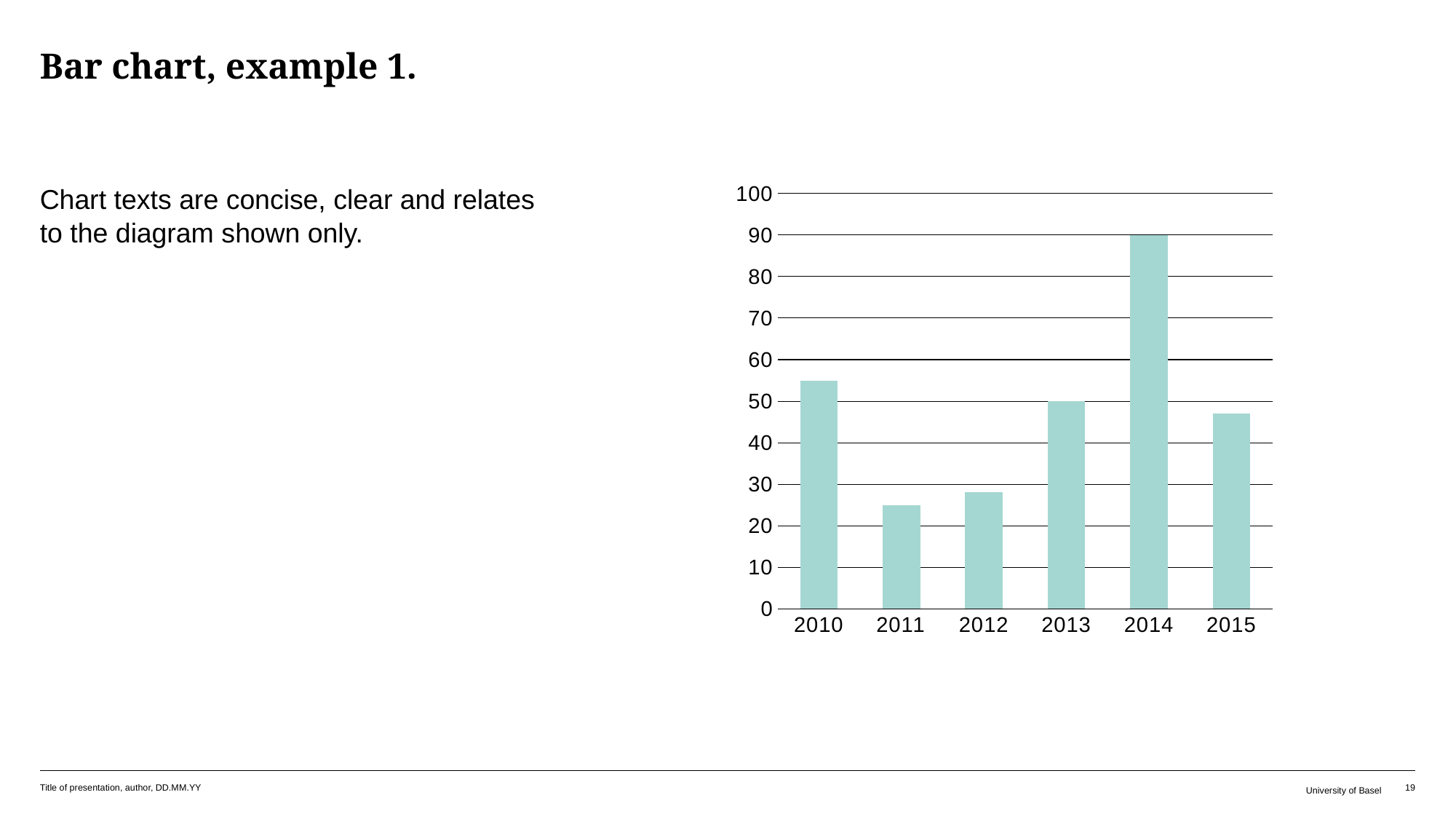
What is the value for 2013? 50 What kind of chart is shown on the slide? bar chart Do the values rise or fall from 2011 to 2014? rise Which year has the lowest value? 2011 What is the difference between the values for 2014 and 2013? 40 Which is larger, the value for 2010 or the value for 2015? 2010 Is the value for 2010 greater or less than 50? greater How many years are shown on the x axis of the chart? 6 Is the value for 2015 greater or less than 50? less Is the value for 2011 greater or less than 30? less What is the value for 2014? 90 Which year has the highest value? 2014